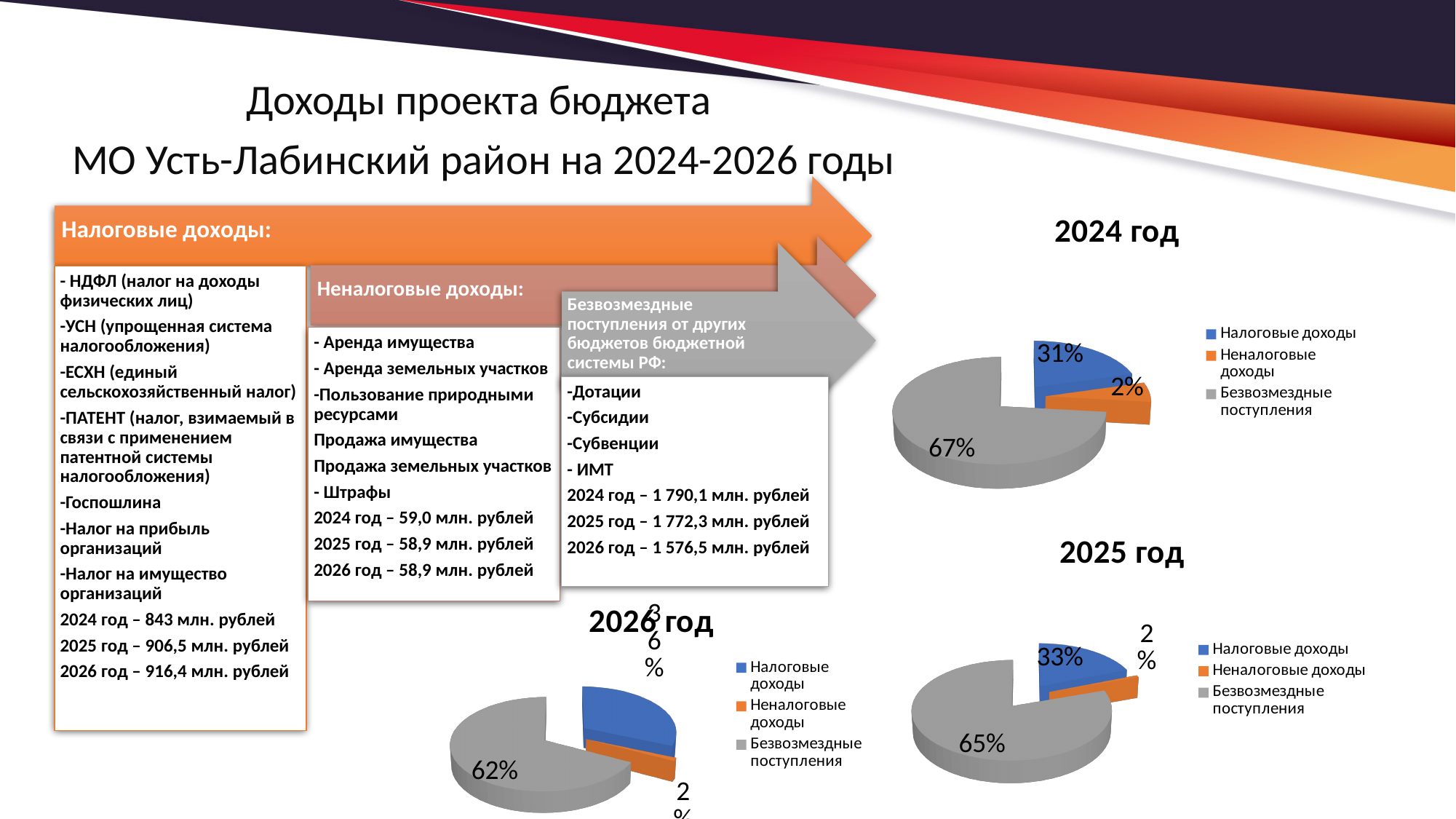
In the '2024 год' chart, what share is shown for Неналоговые доходы? 2% In the '2024 год' chart, what share is shown for Налоговые доходы? 31% In the '2025 год' chart, what share is shown for Налоговые доходы? 33% In the '2025 год' chart, what share is shown for Безвозмездные поступления? 65% In the '2025 год' chart, which is larger: Налоговые доходы or Безвозмездные поступления? Безвозмездные поступления How many entries does the legend of the '2025 год' chart list? 3 In the '2024 год' chart, what share is shown for Безвозмездные поступления? 67% In the '2024 год' chart, what is the difference in percentage points between Безвозмездные поступления and Налоговые доходы? 36 What type of chart is the '2024 год' chart? Pie chart In the '2026 год' chart, what share is shown for Безвозмездные поступления? 62% In the '2025 год' chart, which category has the smallest slice? Неналоговые доходы In the '2024 год' chart, which category has the largest slice? Безвозмездные поступления